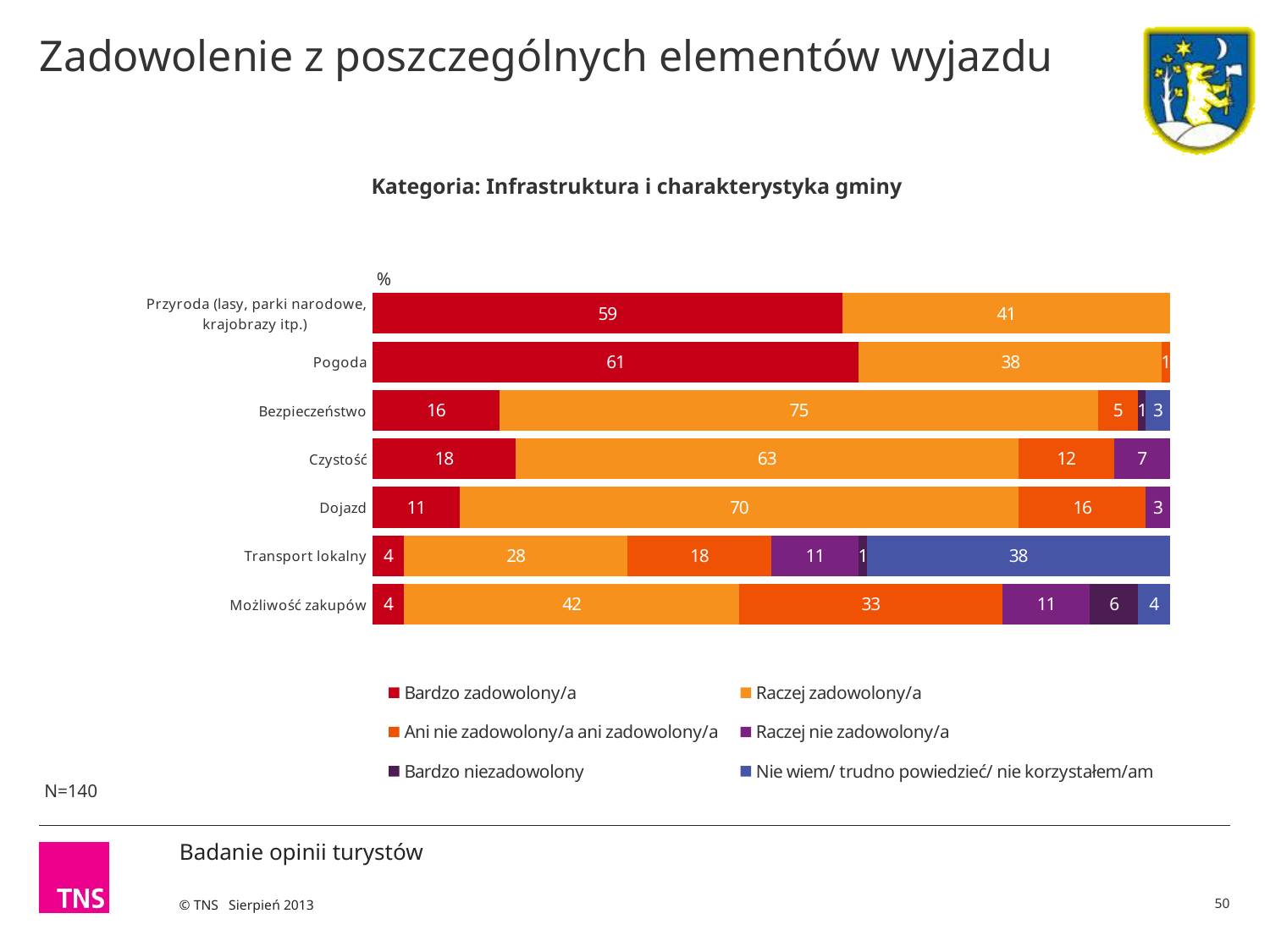
How many series does the chart legend list? 6 What is the value for 'Raczej zadowolony/a' in the 'Bezpieczeństwo' bar? 75 Which has the larger 'Ani nie zadowolony/a ani zadowolony/a' value: 'Możliwość zakupów' or 'Transport lokalny'? Możliwość zakupów What is the value for 'Bardzo zadowolony/a' in the 'Pogoda' bar? 61 What kind of chart is shown on the slide? Stacked bar chart What is the value for 'Raczej nie zadowolony/a' in the 'Czystość' bar? 7 What is the difference between the 'Raczej zadowolony/a' values for 'Dojazd' and 'Czystość'? 7 What sample size (N) is stated on the slide? N=140 Which category has the highest 'Nie wiem/ trudno powiedzieć/ nie korzystałem/am' value? Transport lokalny Which category has the highest 'Bardzo zadowolony/a' value? Pogoda How many categories (elements of the trip) are listed on the chart? 7 What is the total of the stacked bar for 'Czystość'? 100